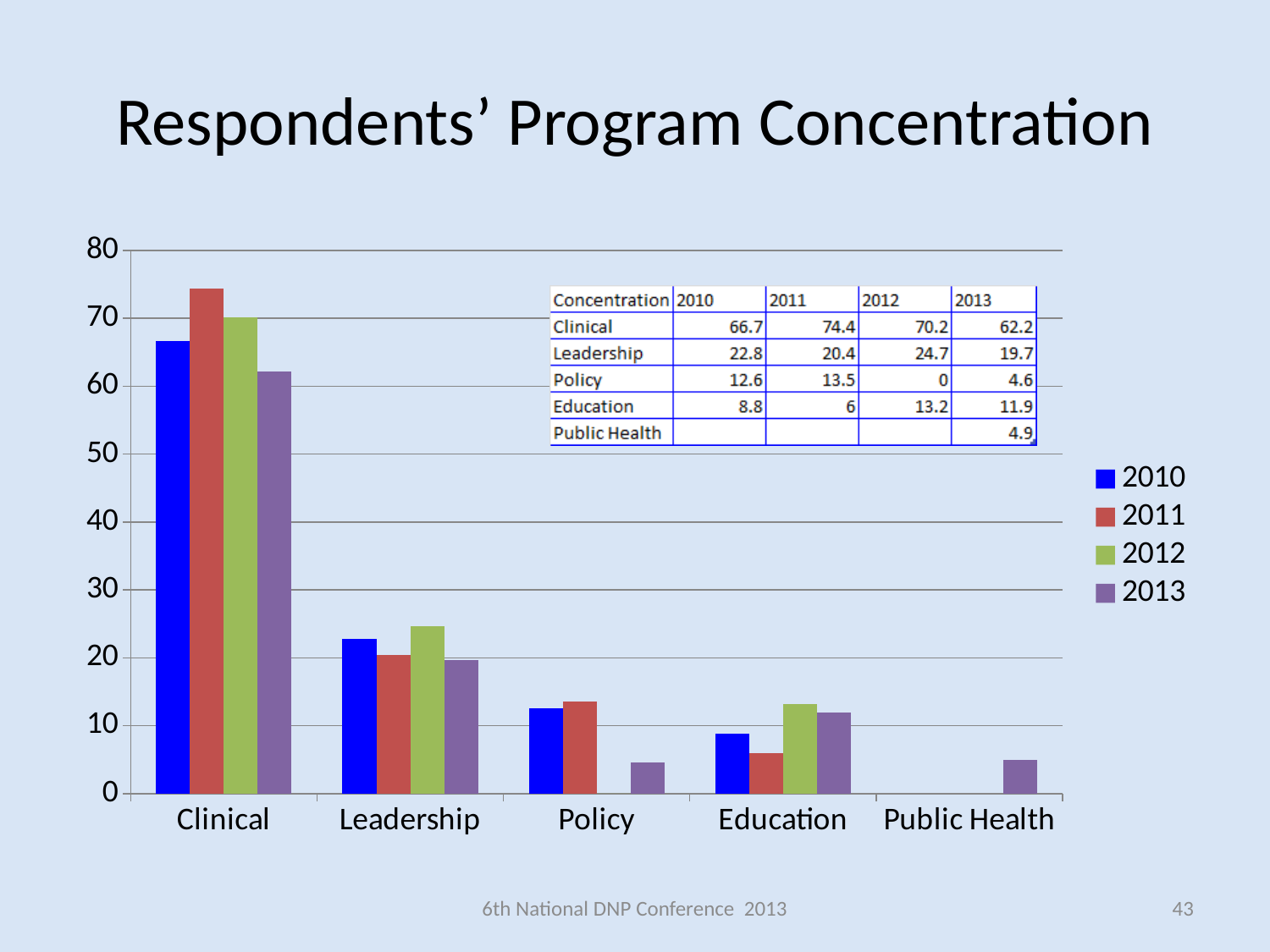
How many series does the legend list? 4 What is the difference between the Clinical values for 2011 and 2013? 12.2 Is the value for Leadership in 2010 greater or less than 20? greater What is the value for Leadership in 2012? 24.7 What is the title of the chart? Respondents' Program Concentration Which is larger, the Education value for 2012 or for 2013? 2012 How many categories are shown on the x axis? 5 What is the value for Public Health in 2013? 4.9 What is the value for Clinical in 2011? 74.4 Which year has the lowest value for Clinical? 2013 Which category has the highest value in 2010? Clinical What kind of chart is shown on the slide? bar chart